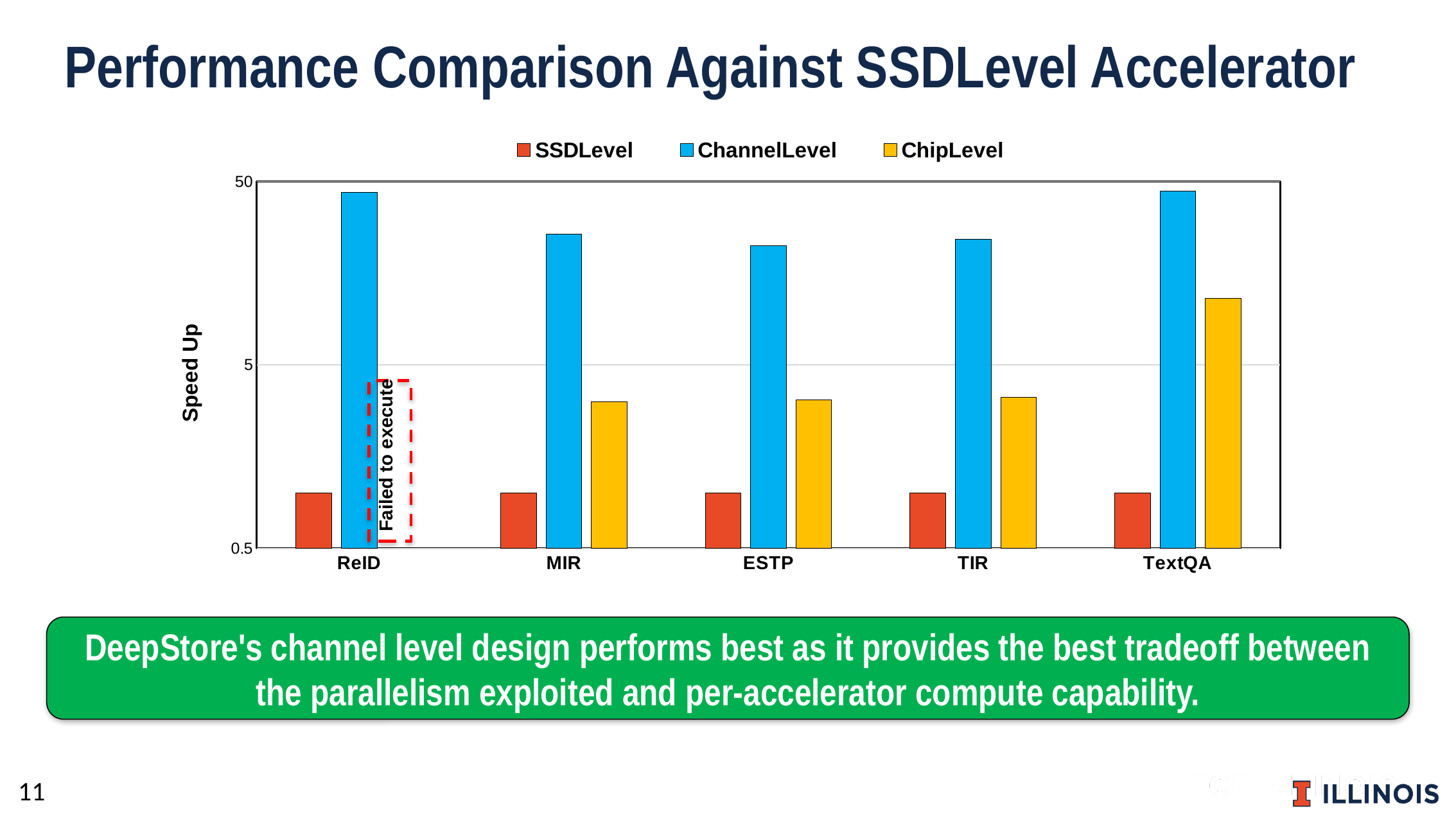
Which series failed to execute for the ReID workload? ChipLevel What kind of chart is shown on the slide? bar chart How many categories are shown on the x axis of the chart? 5 Is the ChipLevel speed up for MIR greater or less than 5? less Is the ChannelLevel speed up for TextQA greater or less than 5? greater Is the ChannelLevel speed up for ReID greater or less than 5? greater For TextQA, which is larger: the ChannelLevel speed up or the ChipLevel speed up? ChannelLevel How many series does the chart's legend list? 3 For TIR, which is larger: the SSDLevel speed up or the ChipLevel speed up? ChipLevel Among the ChipLevel bars, which workload has the highest speed up? TextQA What is the label of the y axis? Speed Up